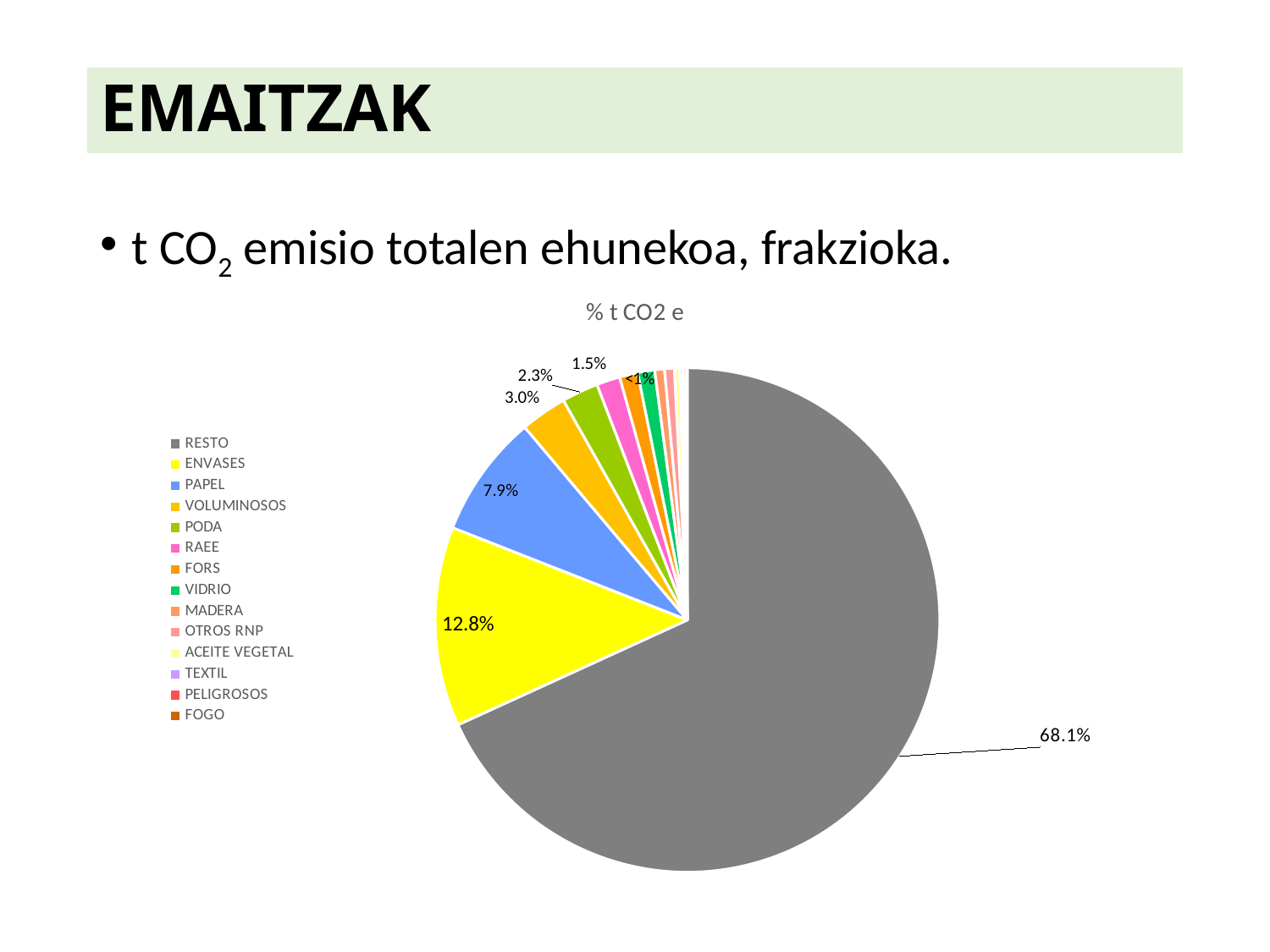
What is the value shown for ENVASES? 12.8% What is the value shown for PAPEL? 7.9% What is the value shown for VOLUMINOSOS? 3.0% What is the combined share of RESTO and ENVASES? 80.9% What kind of chart is shown on the slide? pie chart Which category has the largest share of the pie? RESTO What is the difference between the shares of RESTO and ENVASES? 55.3 percentage points What share of the pie does RESTO have? 68.1% How many categories does the chart's legend list? 14 What is the value shown for PODA? 2.3% What is the title of the chart? % t CO2 e Which has a larger share, ENVASES or PAPEL? ENVASES